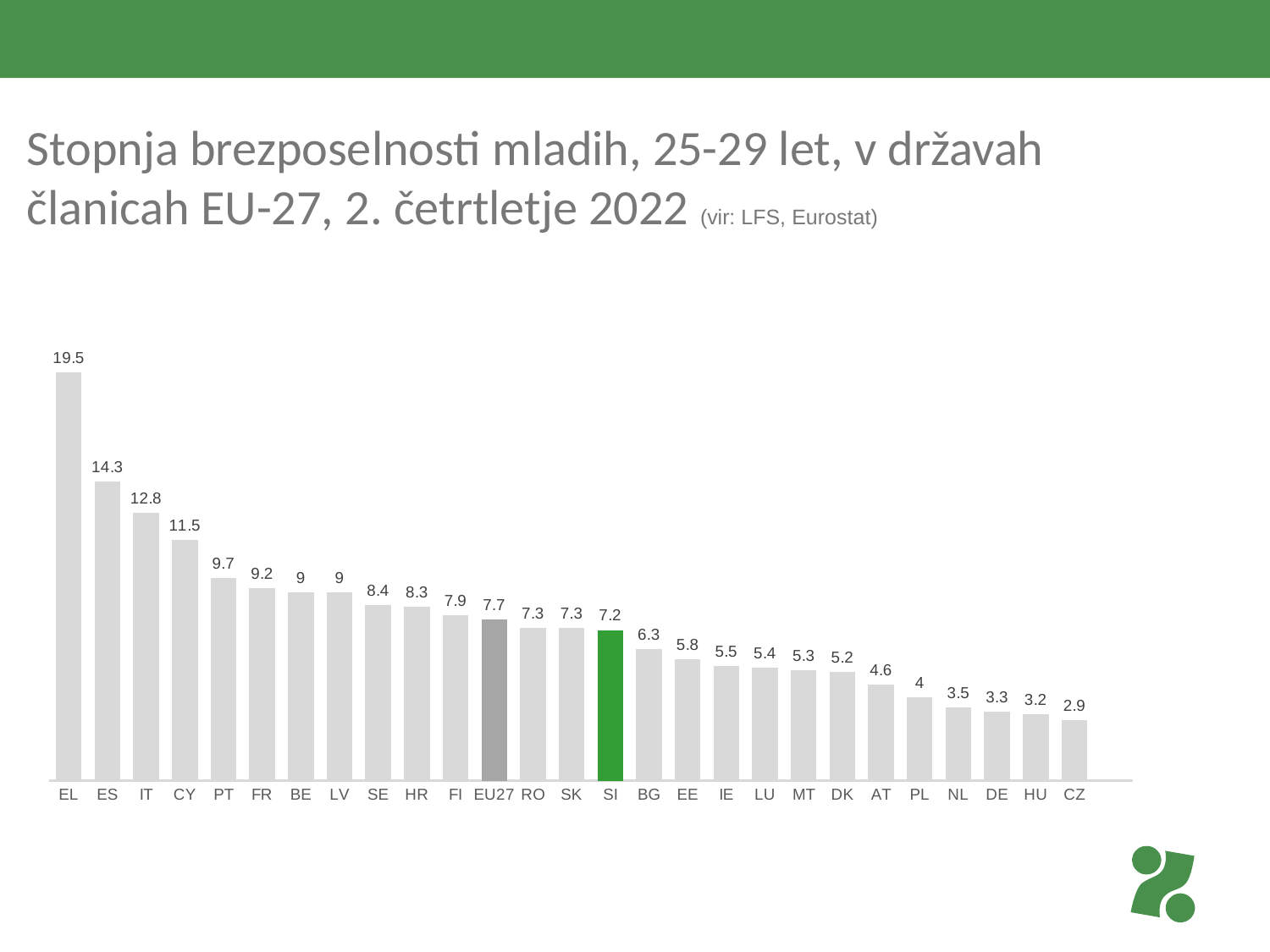
What is the difference between the values for EU27 and SI? 0.5 How many categories are shown on the x axis? 27 Do the values rise or fall from left to right along the x axis? fall What is the value for EU27? 7.7 Which category has the lowest value? CZ What is the value for PT? 9.7 What kind of chart is this? bar chart Which bar is coloured green? SI Which category has the highest value? EL Which is larger, the value for IT or the value for CY? IT What is the difference between the values for EL and ES? 5.2 What is the value for SI? 7.2